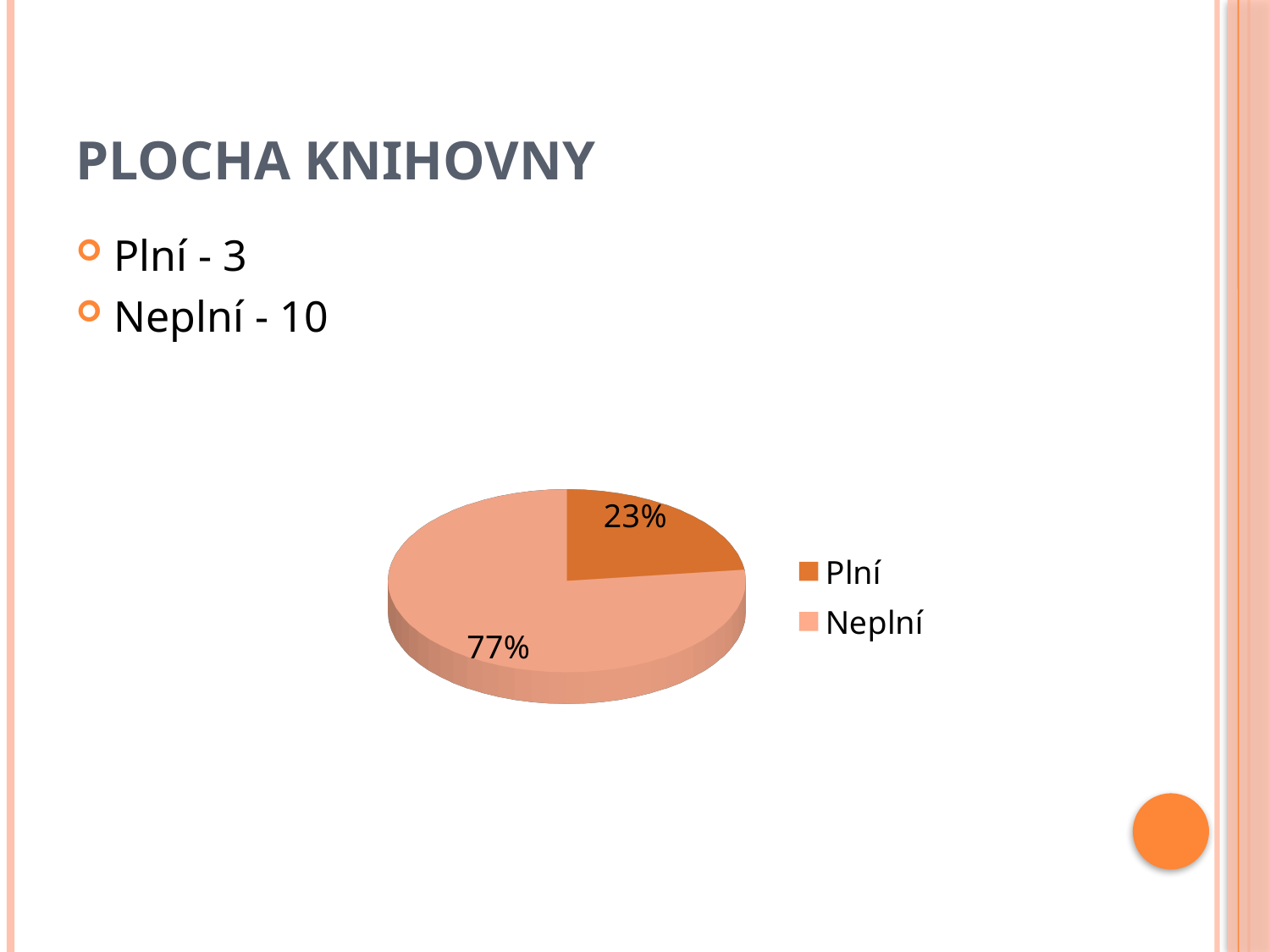
What share of the pie does the Plní slice represent? 23% How many entries does the legend list? 2 Which slice of the pie is the largest? Neplní How many slices does the pie chart have? 2 What share of the pie does the Neplní slice represent? 77% What is the title of the slide containing the pie chart? Plocha knihovny Which legend entry is shown in the darker orange colour? Plní Which slice of the pie is the smallest? Plní Which is larger, the Plní slice or the Neplní slice? Neplní What is the difference in percentage points between the Neplní slice and the Plní slice? 54 What kind of chart is shown on the slide? pie chart